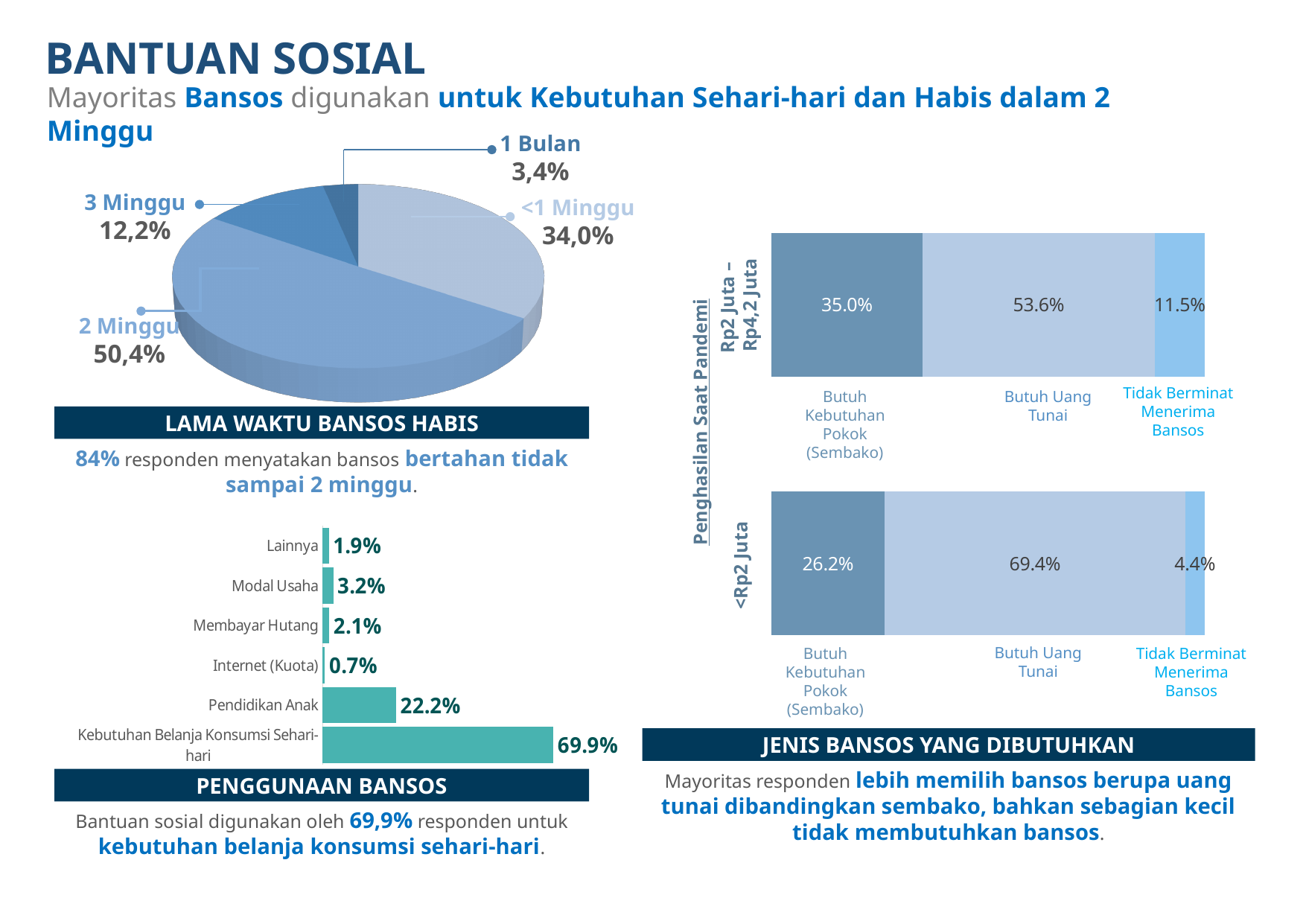
In the LAMA WAKTU BANSOS HABIS pie chart, how many slices are there? 4 In the LAMA WAKTU BANSOS HABIS pie chart, which category has the smallest slice? 1 Bulan In the JENIS BANSOS YANG DIBUTUHKAN chart, what is the value for Butuh Uang Tunai in the <Rp2 Juta bar? 69.4% In the PENGGUNAAN BANSOS chart, what is the value for Pendidikan Anak? 22.2% In the PENGGUNAAN BANSOS chart, which category has the highest value? Kebutuhan Belanja Konsumsi Sehari-hari What kind of chart is PENGGUNAAN BANSOS? Bar chart In the JENIS BANSOS YANG DIBUTUHKAN chart, what is the difference between Tidak Berminat Menerima Bansos for Rp2 Juta – Rp4,2 Juta and for <Rp2 Juta? 7.1% In the PENGGUNAAN BANSOS chart, what is the difference between Modal Usaha and Membayar Hutang? 1.1% In the LAMA WAKTU BANSOS HABIS pie chart, which is larger: <1 Minggu or 3 Minggu? <1 Minggu In the PENGGUNAAN BANSOS chart, which category has the lowest value? Internet (Kuota) What kind of chart is LAMA WAKTU BANSOS HABIS? Pie chart In the LAMA WAKTU BANSOS HABIS pie chart, what share is shown for 2 Minggu? 50,4%